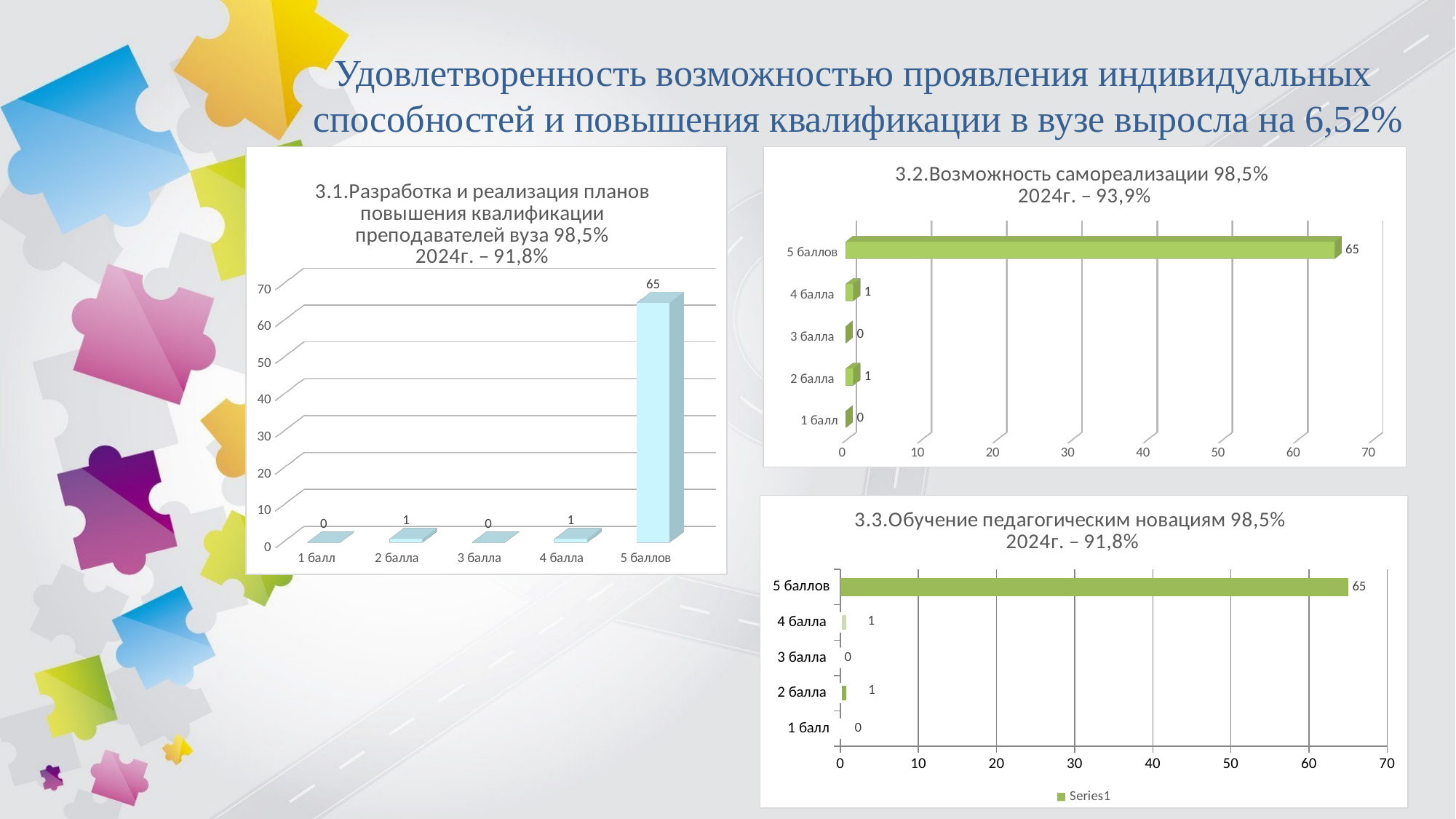
What kind of chart is the chart titled "3.2.Возможность самореализации"? bar chart In the chart titled "3.3.Обучение педагогическим новациям", what is the value for 3 балла? 0 In the chart titled "3.3.Обучение педагогическим новациям", which is larger, the value for 2 балла or the value for 1 балл? 2 балла In the chart titled "3.1.Разработка и реализация планов повышения квалификации преподавателей вуза", which category has the highest value? 5 баллов In the chart titled "3.2.Возможность самореализации", is the value for 5 баллов greater or less than 60? greater In the chart titled "3.3.Обучение педагогическим новациям", how many series does the legend list? 1 In the chart titled "3.1.Разработка и реализация планов повышения квалификации преподавателей вуза", what is the value for 2 балла? 1 In the chart titled "3.1.Разработка и реализация планов повышения квалификации преподавателей вуза", how many categories are shown on the x axis? 5 In the chart titled "3.1.Разработка и реализация планов повышения квалификации преподавателей вуза", what is the value for 5 баллов? 65 In the chart titled "3.3.Обучение педагогическим новациям", what is the name of the series shown in the legend? Series1 In the chart titled "3.2.Возможность самореализации", what is the difference between the values for 5 баллов and 4 балла? 64 In the chart titled "3.2.Возможность самореализации", what is the value for 4 балла? 1